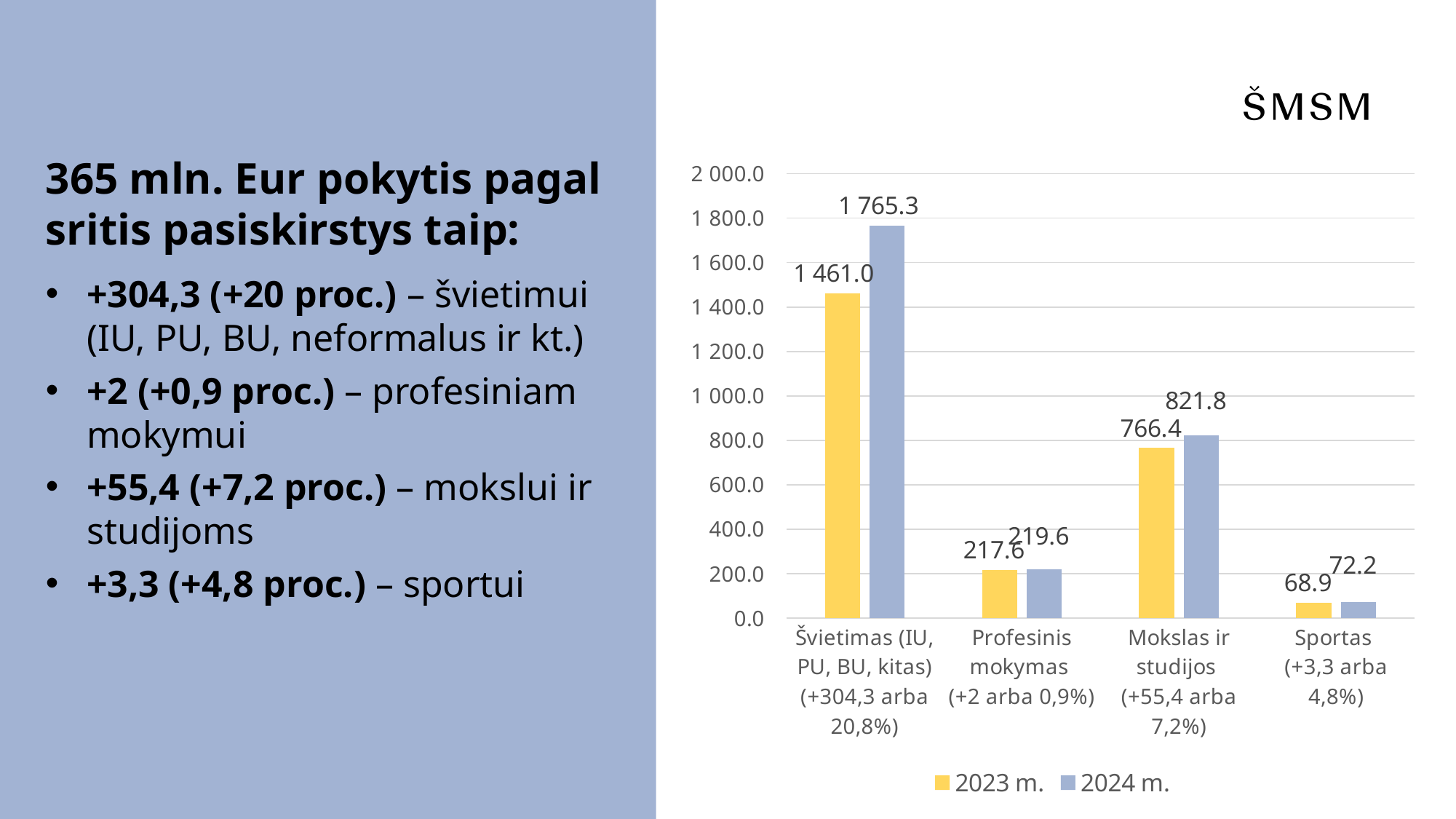
Which category has the highest 2024 m. value? Švietimas (IU, PU, BU, kitas) How many categories are shown on the x axis of the chart? 4 What is the 2024 m. value for Švietimas (IU, PU, BU, kitas)? 1 765.3 How many series does the legend list? 2 What is the 2024 m. value for Profesinis mokymas? 219.6 What is the difference between the 2024 m. and 2023 m. values for Švietimas (IU, PU, BU, kitas)? 304.3 Which is larger: the 2023 m. value for Mokslas ir studijos or the 2023 m. value for Profesinis mokymas? Mokslas ir studijos What is the 2023 m. value for Sportas? 68.9 What type of chart is shown on the slide? Bar chart Which category has the lowest 2023 m. value? Sportas What is the difference between the 2024 m. and 2023 m. values for Mokslas ir studijos? 55.4 What is the 2023 m. value for Mokslas ir studijos? 766.4